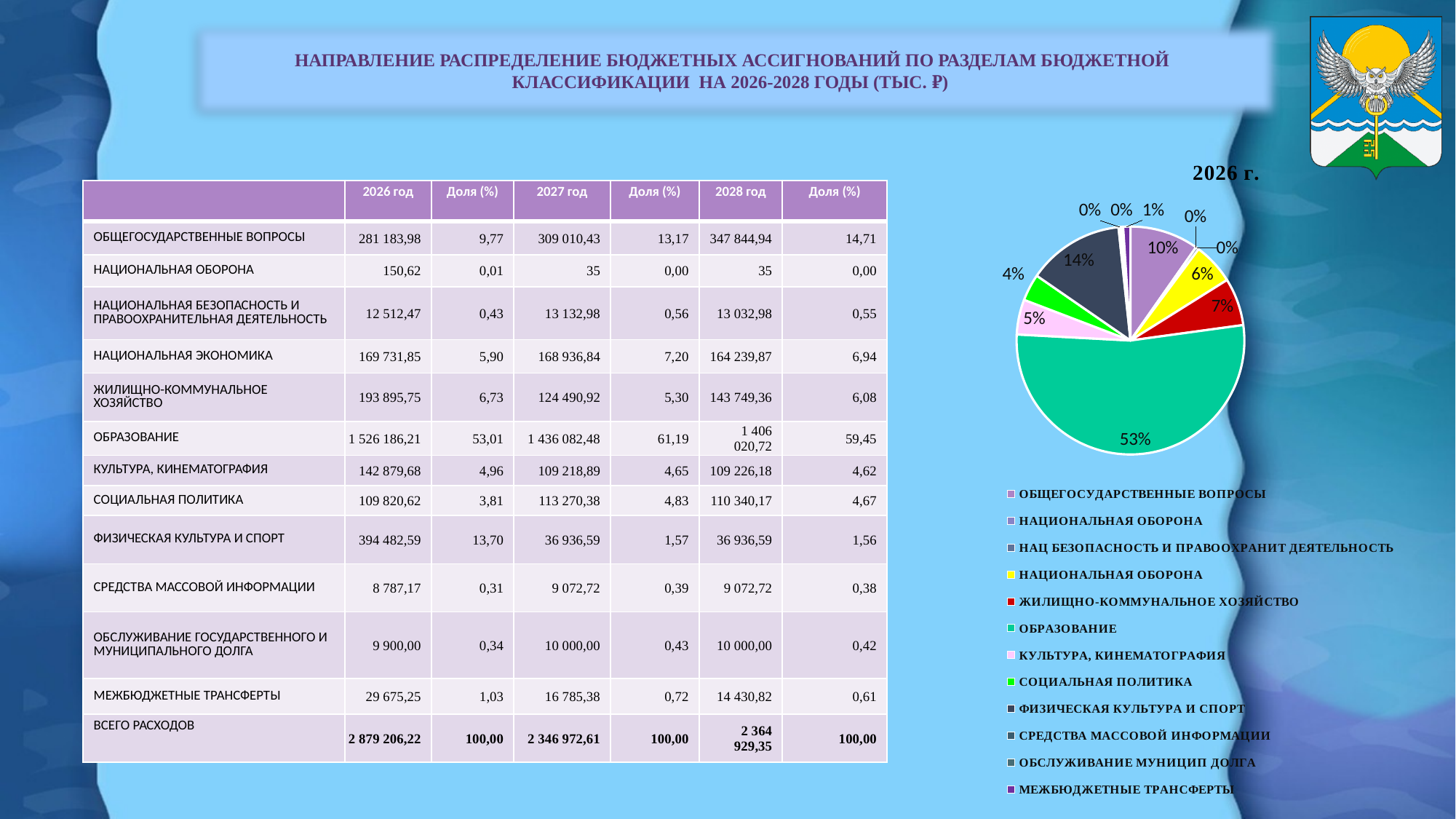
What share of the pie chart does КУЛЬТУРА, КИНЕМАТОГРАФИЯ take? 5% Which category has the largest slice in the pie chart? ОБРАЗОВАНИЕ What is the title of the pie chart? 2026 г. What kind of chart is shown on the right side of the slide? pie chart In the pie chart, which slice is larger: ЖИЛИЩНО-КОММУНАЛЬНОЕ ХОЗЯЙСТВО or КУЛЬТУРА, КИНЕМАТОГРАФИЯ? ЖИЛИЩНО-КОММУНАЛЬНОЕ ХОЗЯЙСТВО What share of the pie chart does СОЦИАЛЬНАЯ ПОЛИТИКА take? 4% What share of the pie chart does ОБРАЗОВАНИЕ take? 53% In the pie chart, by how many percentage points does the ОБРАЗОВАНИЕ share exceed the ФИЗИЧЕСКАЯ КУЛЬТУРА И СПОРТ share? 39 How many entries does the legend of the pie chart list? 12